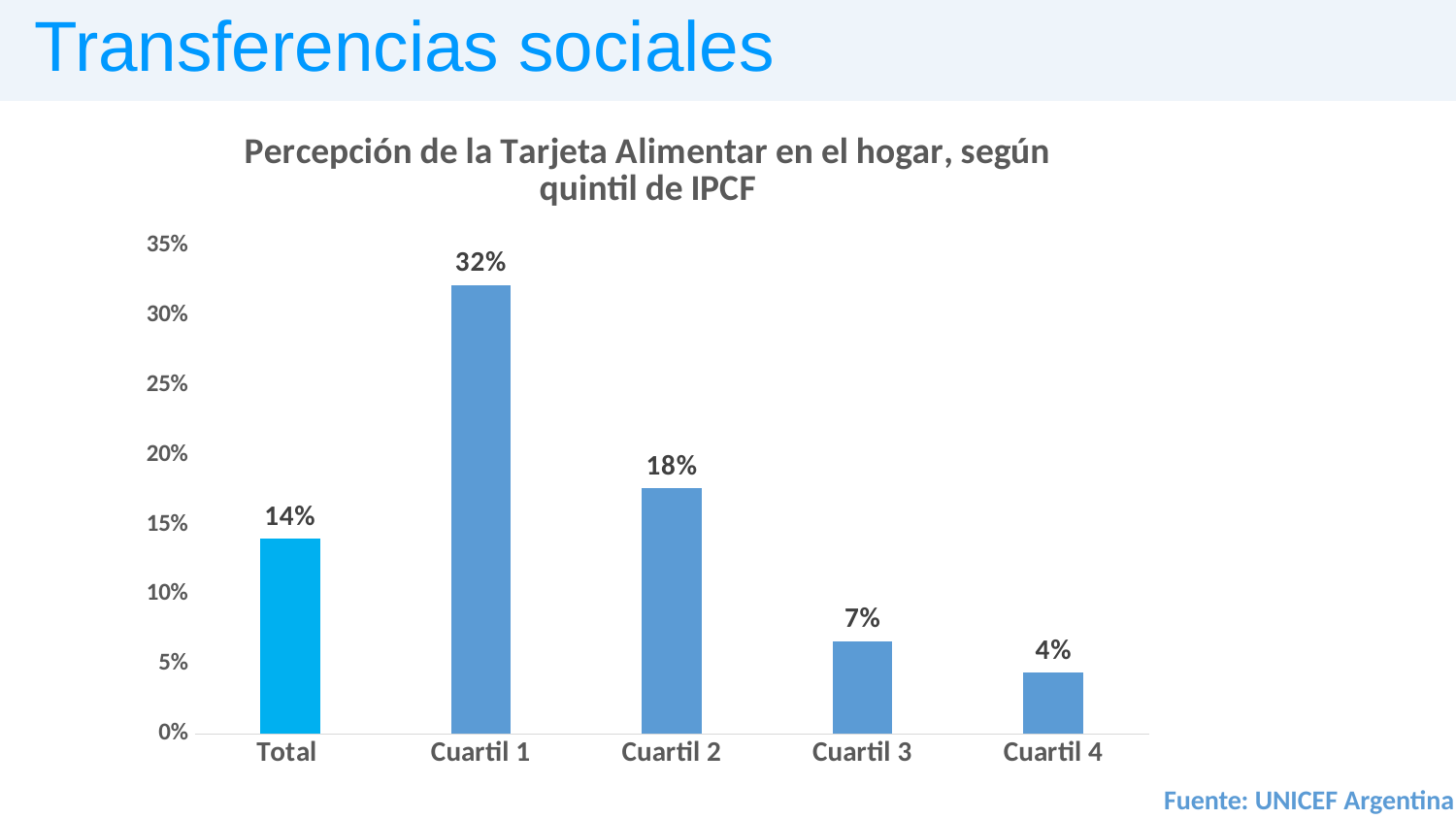
Which category has the lowest value? Cuartil 4 Is the value for Cuartil 1 greater or less than 30%? greater What is the difference between the values for Cuartil 1 and Cuartil 2? 14% What is the title of the chart? Percepción de la Tarjeta Alimentar en el hogar, según quintil de IPCF How many categories are shown on the x axis? 5 What is the value for Total? 14% Which category has the highest value? Cuartil 1 Do the values rise or fall from Cuartil 1 to Cuartil 4? fall Which is larger, the value for Cuartil 2 or the value for Cuartil 3? Cuartil 2 What is the value for Cuartil 1? 32% What is the value for Cuartil 4? 4% What kind of chart is shown on the slide? bar chart